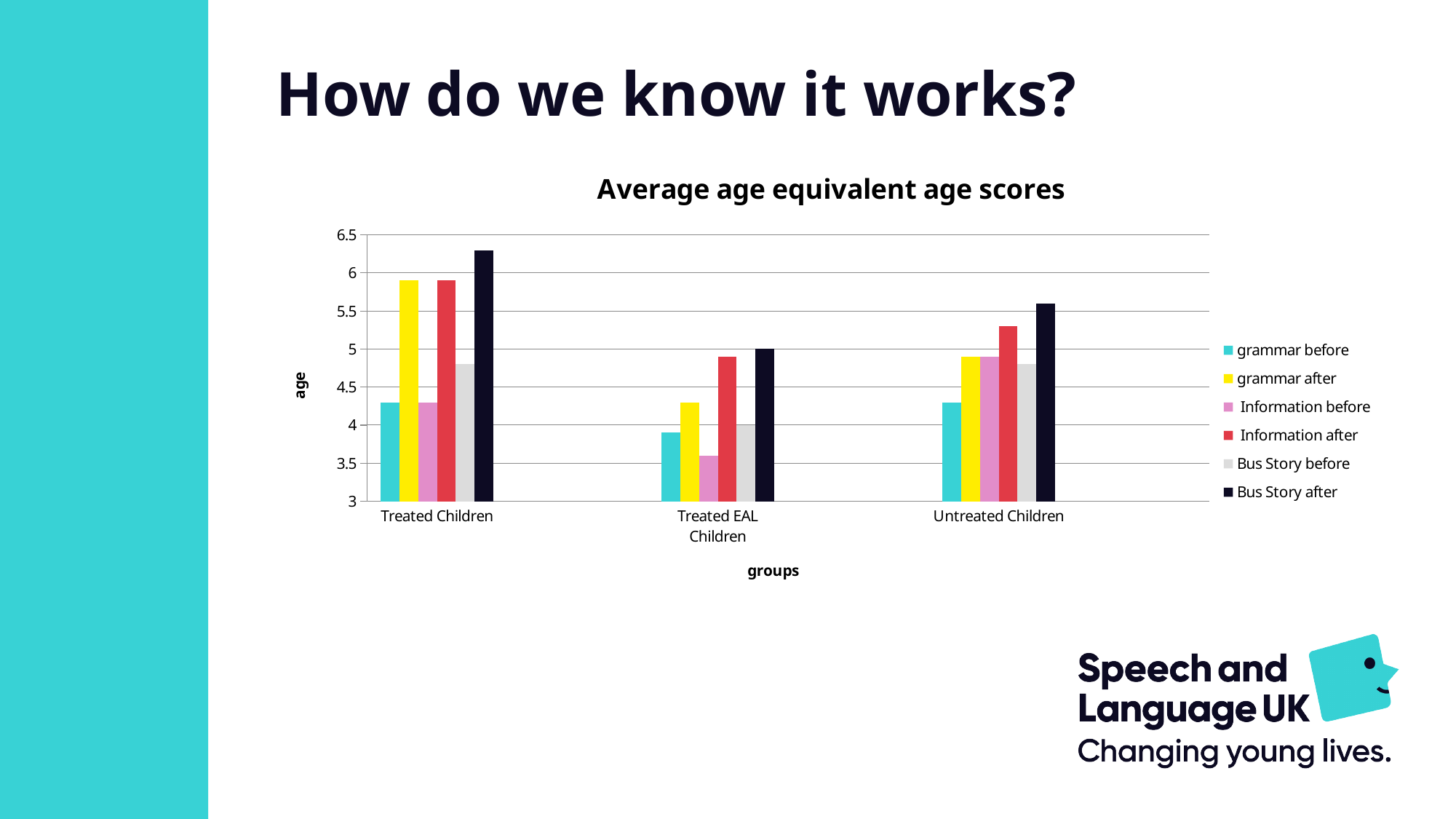
Which group has the highest Bus Story after score? Treated Children Which group has the lowest Information before score? Treated EAL Children Is the Information after value for Untreated Children greater or less than 5? greater How many series does the legend list? 6 Is the Information before value for Treated EAL Children greater or less than 4? less What is the label of the vertical axis? age Which is larger: the grammar after score for Treated Children or for Untreated Children? Treated Children Is the Bus Story after value for Treated Children greater or less than 6? greater What kind of chart is shown on the slide? bar chart What is the title of the chart? Average age equivalent age scores How many groups are shown on the x axis? 3